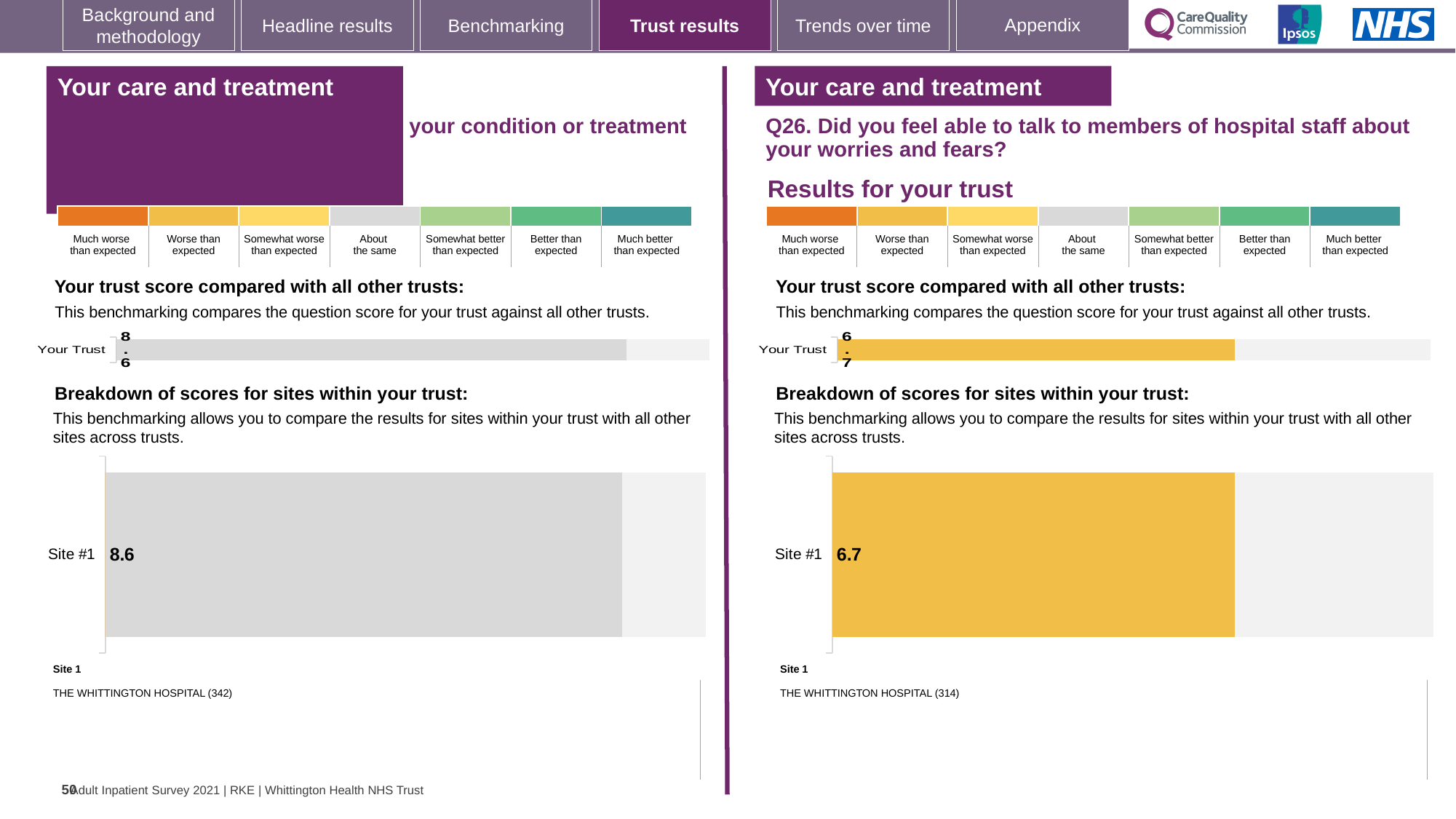
How many sites are shown in the left-hand site breakdown chart? 1 Which site is listed as Site 1 under the right-hand Q26 breakdown chart? THE WHITTINGTON HOSPITAL (314) How many sites are shown in the right-hand Q26 site breakdown chart? 1 On the left-hand chart, what is the 'Your Trust' score? 8.6 On the left-hand site breakdown chart, what is the score for Site #1? 8.6 On the right-hand Q26 site breakdown chart, what is the score for Site #1? 6.7 Which is larger: the 'Your Trust' score on the left-hand chart or the 'Your Trust' score on the right-hand Q26 chart? Left-hand chart (8.6) What type of chart is used to show the Site #1 score on the right-hand Q26 breakdown? Bar chart On the left-hand chart, which benchmark category does the colour of the 'Your Trust' bar correspond to? About the same On the right-hand chart for Q26, what is the 'Your Trust' score? 6.7 On the right-hand Q26 chart, which benchmark category does the colour of the 'Your Trust' bar correspond to? Worse than expected What is the difference between the Site #1 score on the left-hand chart (8.6) and the Site #1 score on the right-hand Q26 chart (6.7)? 1.9